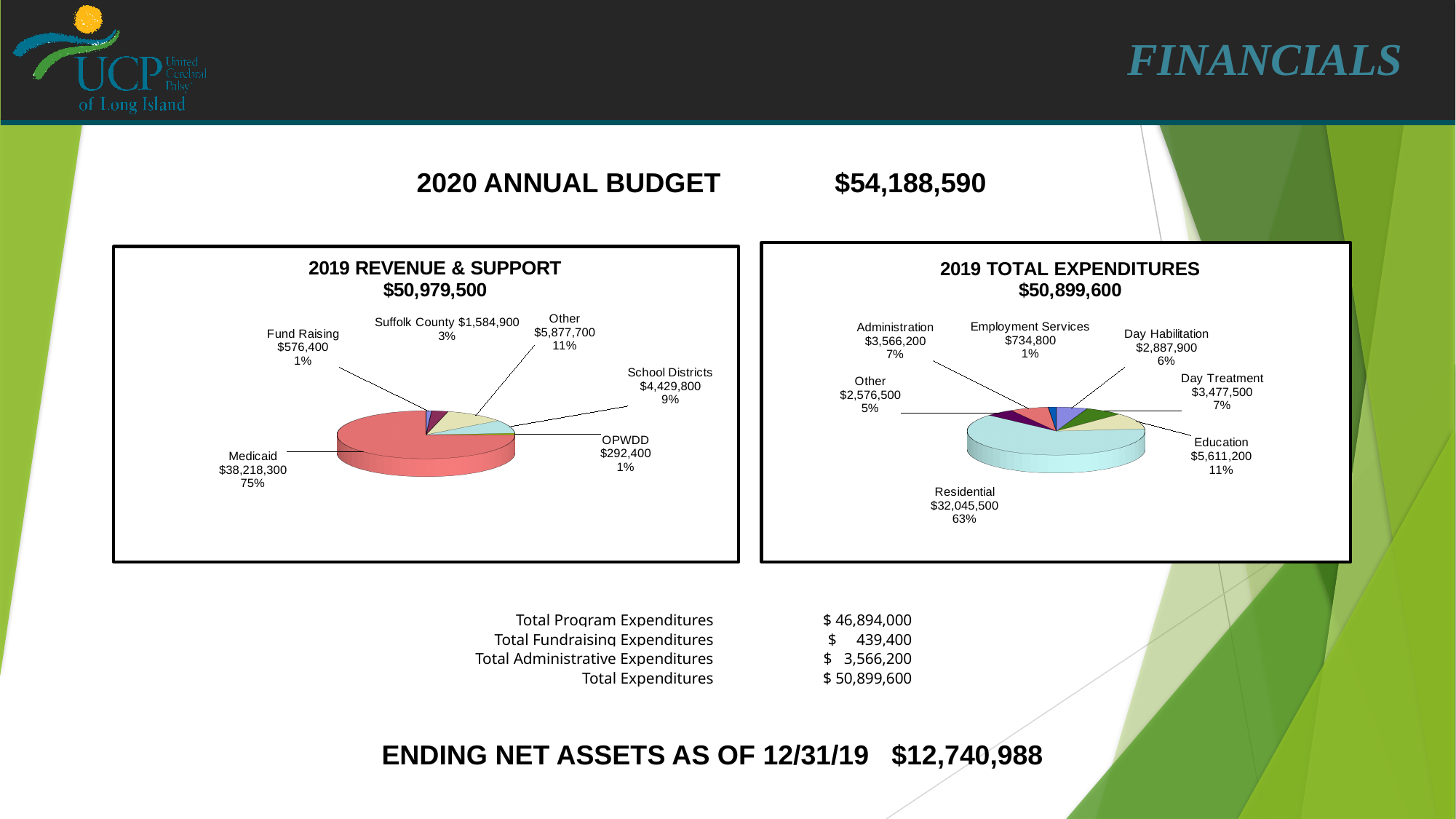
In the 2019 Total Expenditures chart, what is the difference between Administration and Day Treatment? $88,700 In the 2019 Total Expenditures chart, what is the value for Education? $5,611,200 In the 2019 Revenue & Support chart, which category is the largest? Medicaid What kind of chart is the 2019 Total Expenditures chart? Pie chart In the 2019 Total Expenditures chart, how many categories are shown? 7 In the 2019 Total Expenditures chart, which category is the smallest? Employment Services In the 2019 Revenue & Support chart, which is larger, Fund Raising or OPWDD? Fund Raising In the 2019 Total Expenditures chart, what share of the pie does Residential represent? 63% In the 2019 Revenue & Support chart, what is the difference between Other and Suffolk County? $4,292,800 In the 2019 Revenue & Support chart, how many categories are shown? 6 In the 2019 Revenue & Support chart, what share of the pie does School Districts represent? 9% In the 2019 Revenue & Support chart, what is the value for Medicaid? $38,218,300